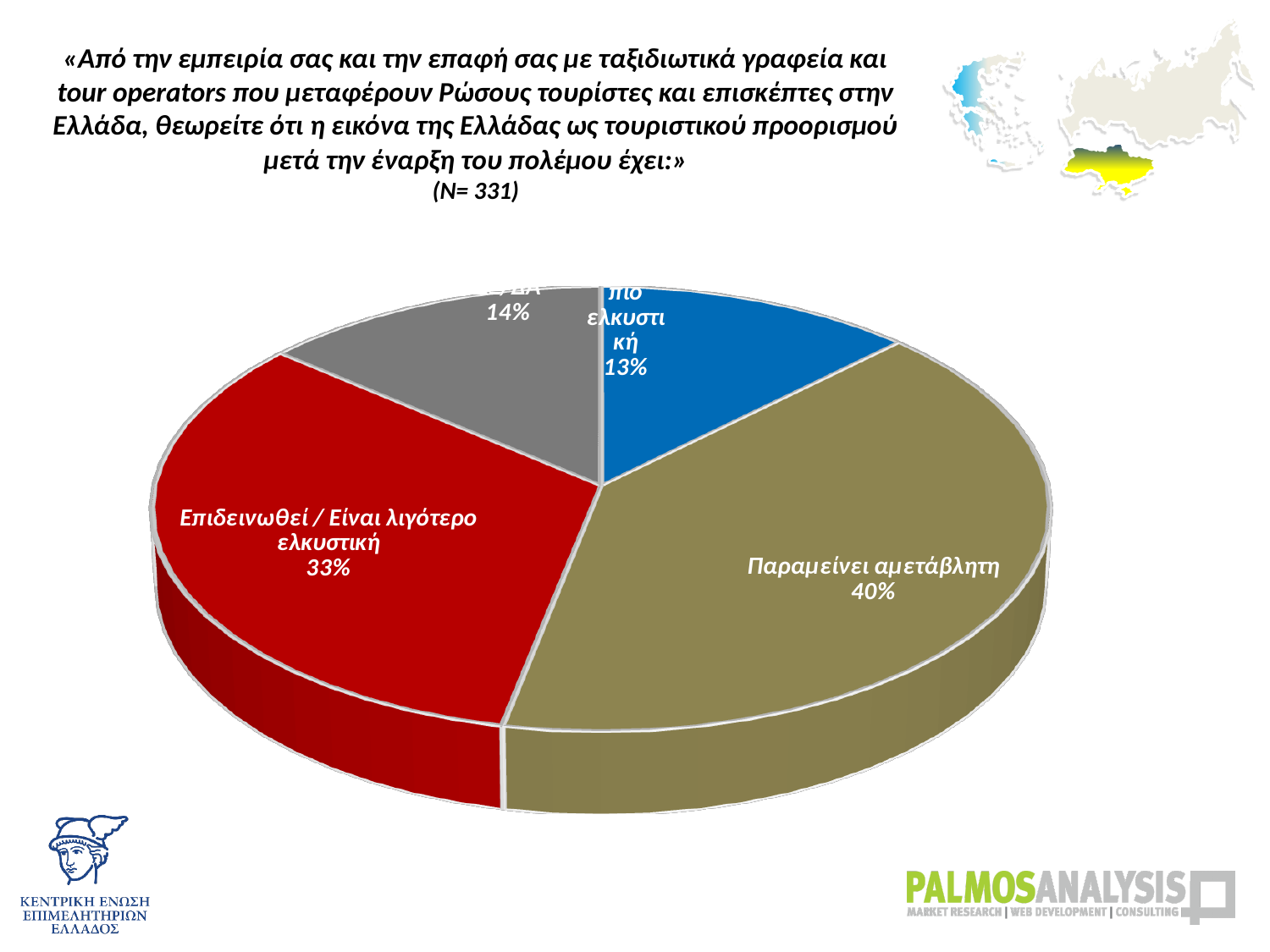
Which response has the smallest share of the pie? πιο ελκυστική What percentage is shown on the grey slice of the pie chart? 14% What type of chart is shown on the slide? pie chart How many slices does the pie chart have? 4 What colour is the slice for "Επιδεινωθεί / Είναι λιγότερο ελκυστική"? red Which is larger: the share for "Επιδεινωθεί / Είναι λιγότερο ελκυστική" or the share for "Παραμείνει αμετάβλητη"? Παραμείνει αμετάβλητη What percentage of respondents answered "Επιδεινωθεί / Είναι λιγότερο ελκυστική"? 33% Which response has the largest share of the pie? Παραμείνει αμετάβλητη What is the difference in percentage points between "Παραμείνει αμετάβλητη" and "Επιδεινωθεί / Είναι λιγότερο ελκυστική"? 7 percentage points What percentage is shown for the blue slice labelled "πιο ελκυστική"? 13% What percentage of respondents answered "Παραμείνει αμετάβλητη"? 40% What is the sample size (N) stated on the slide? 331